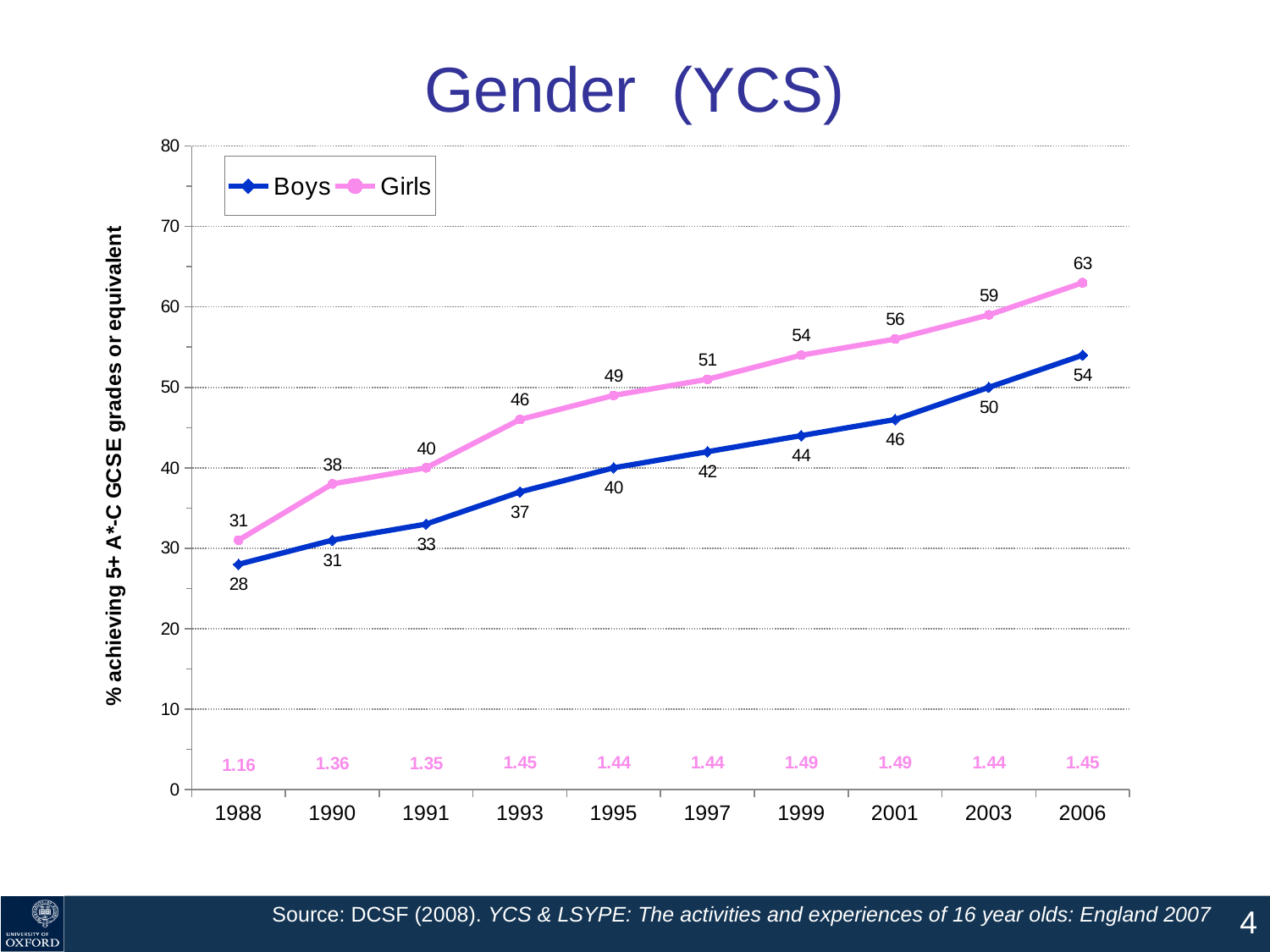
Which is larger in 2001, the value for Boys or the value for Girls? Girls What is the difference between the Girls and Boys values in 2006? 9 What is the value for Boys in 1988? 28 Do the values for Boys rise or fall from 1988 to 2006? Rise In which year is the value for Girls highest? 2006 What kind of chart is shown on the slide? Line chart In which year is the value for Boys lowest? 1988 What is the value for Boys in 1999? 44 What is the value for Girls in 1993? 46 What is the value for Girls in 2006? 63 How many series does the legend list? 2 How many years are shown on the x axis? 10